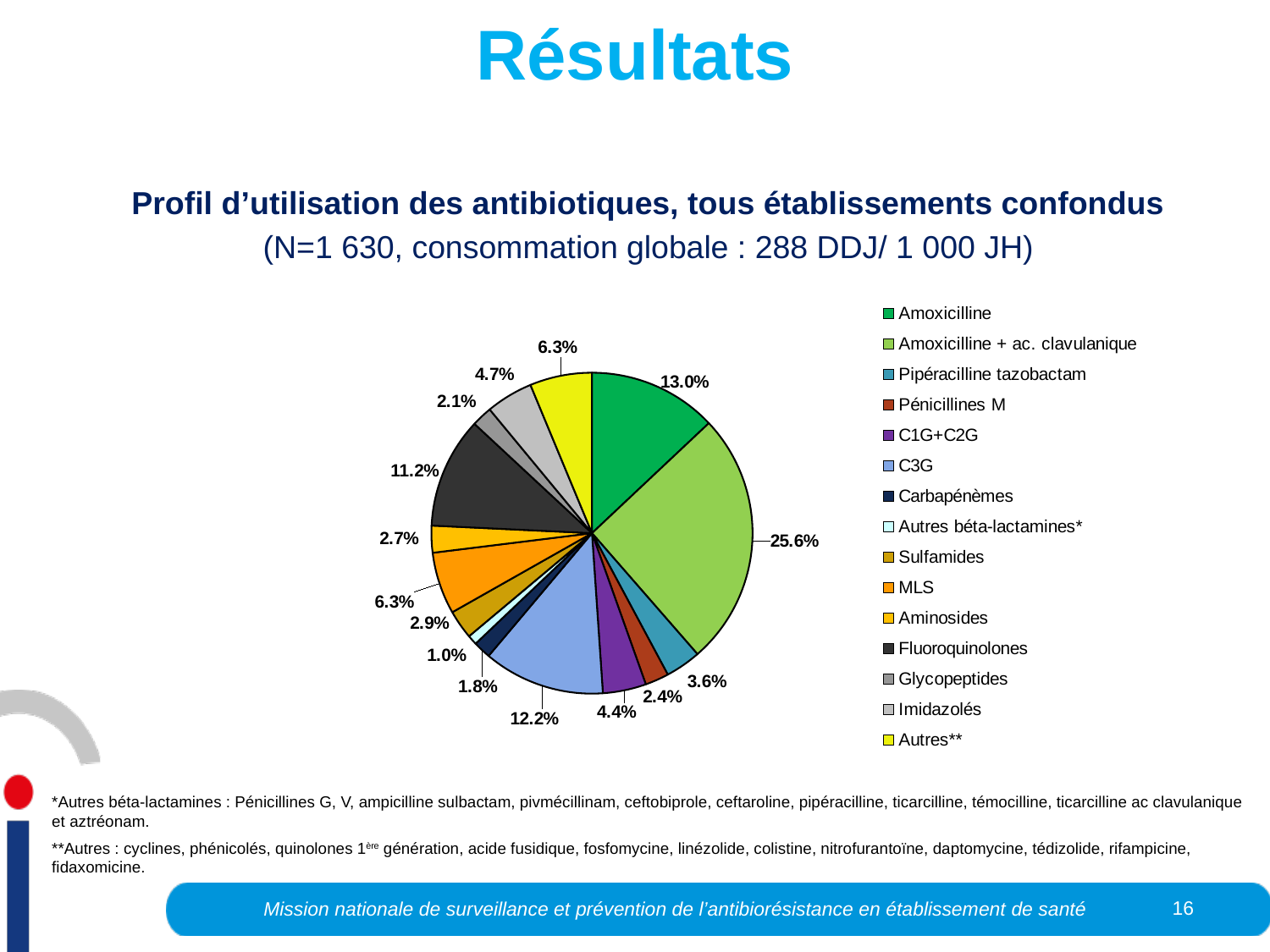
What kind of chart is shown on the slide? pie chart Which category has the smallest slice of the pie? Autres béta-lactamines* What is the value shown for Autres béta-lactamines*? 1.0% How many categories does the legend list? 15 Which is larger, the share for C3G or the share for Fluoroquinolones? C3G What is the combined share of Amoxicilline and Amoxicilline + ac. clavulanique? 38.6% What is the value shown for Amoxicilline? 13.0% What is the value shown for Fluoroquinolones? 11.2% Which category has the largest slice of the pie? Amoxicilline + ac. clavulanique What is the value shown for C3G? 12.2% What is the difference between the shares of Amoxicilline + ac. clavulanique and Amoxicilline? 12.6% What share of the pie does Amoxicilline + ac. clavulanique represent? 25.6%